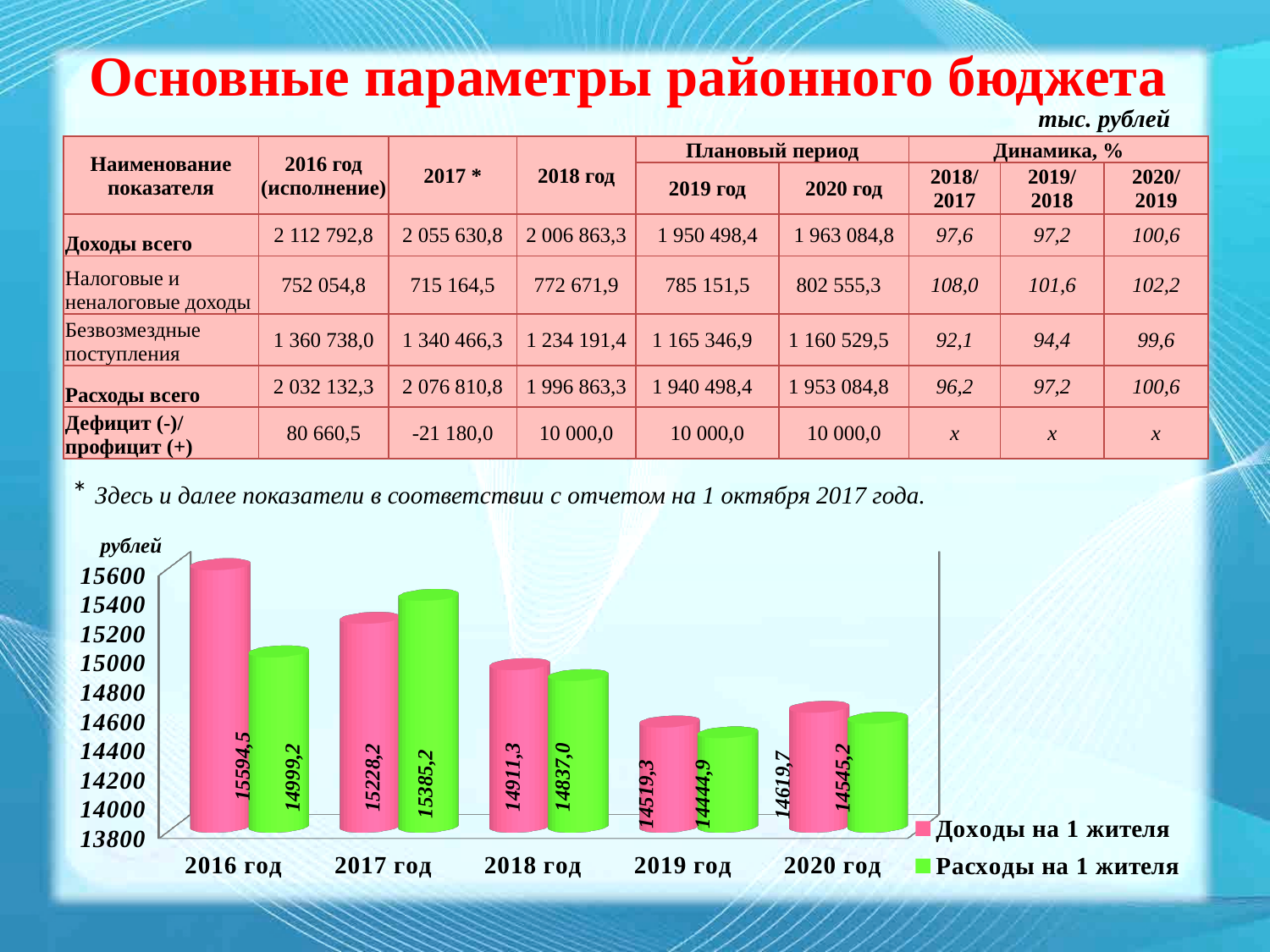
In which year is Расходы на 1 жителя lowest? 2019 год What is the value of Доходы на 1 жителя for 2016 год? 15594,5 How many series does the chart legend list? 2 Is the value of Доходы на 1 жителя for 2018 год greater or less than 15000? less What is the value of Расходы на 1 жителя for 2017 год? 15385,2 What is the difference between Доходы на 1 жителя and Расходы на 1 жителя in 2016 год? 595,3 In which year is Доходы на 1 жителя highest? 2016 год In 2017 год, which is larger: Доходы на 1 жителя or Расходы на 1 жителя? Расходы на 1 жителя What is the value of Расходы на 1 жителя for 2020 год? 14545,2 How many years are shown on the x axis of the chart? 5 What is the value of Доходы на 1 жителя for 2019 год? 14519,3 What kind of chart is shown on the slide? bar chart